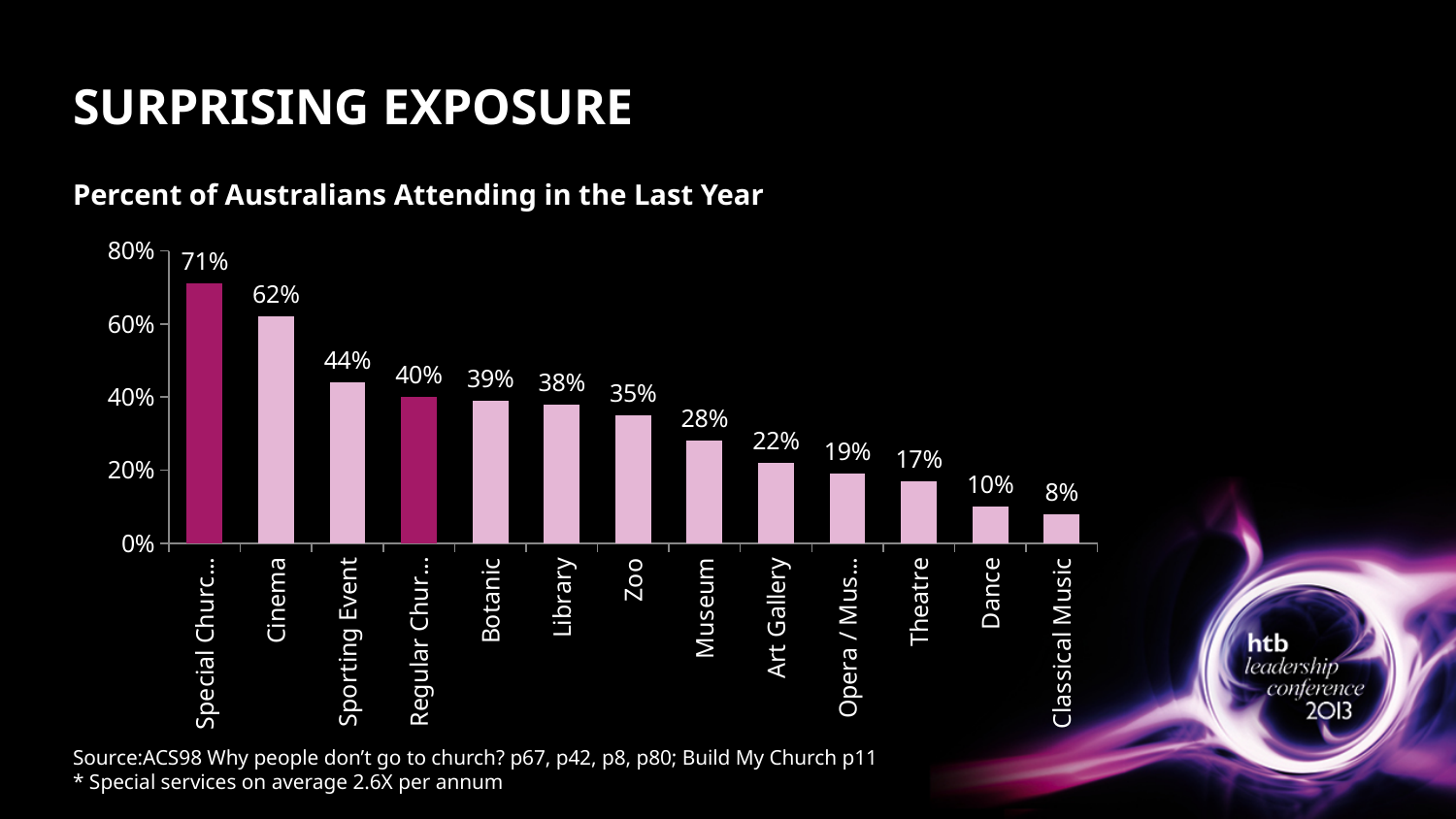
What percent of Australians attended the Cinema in the last year? 62% How many categories are shown on the chart? 13 What kind of chart is shown on the slide? bar chart What is the title of the chart? Percent of Australians Attending in the Last Year What is the difference between the values for Dance and Classical Music? 2% What is the difference between the values for Cinema and Sporting Event? 18% What is the highest value shown on the chart? 71% What is the value for Zoo? 35% What is the value for Theatre? 17% Which category has the lowest value? Classical Music Do the values rise or fall from left to right along the x axis? fall Which is larger, the value for Museum or the value for Art Gallery? Museum